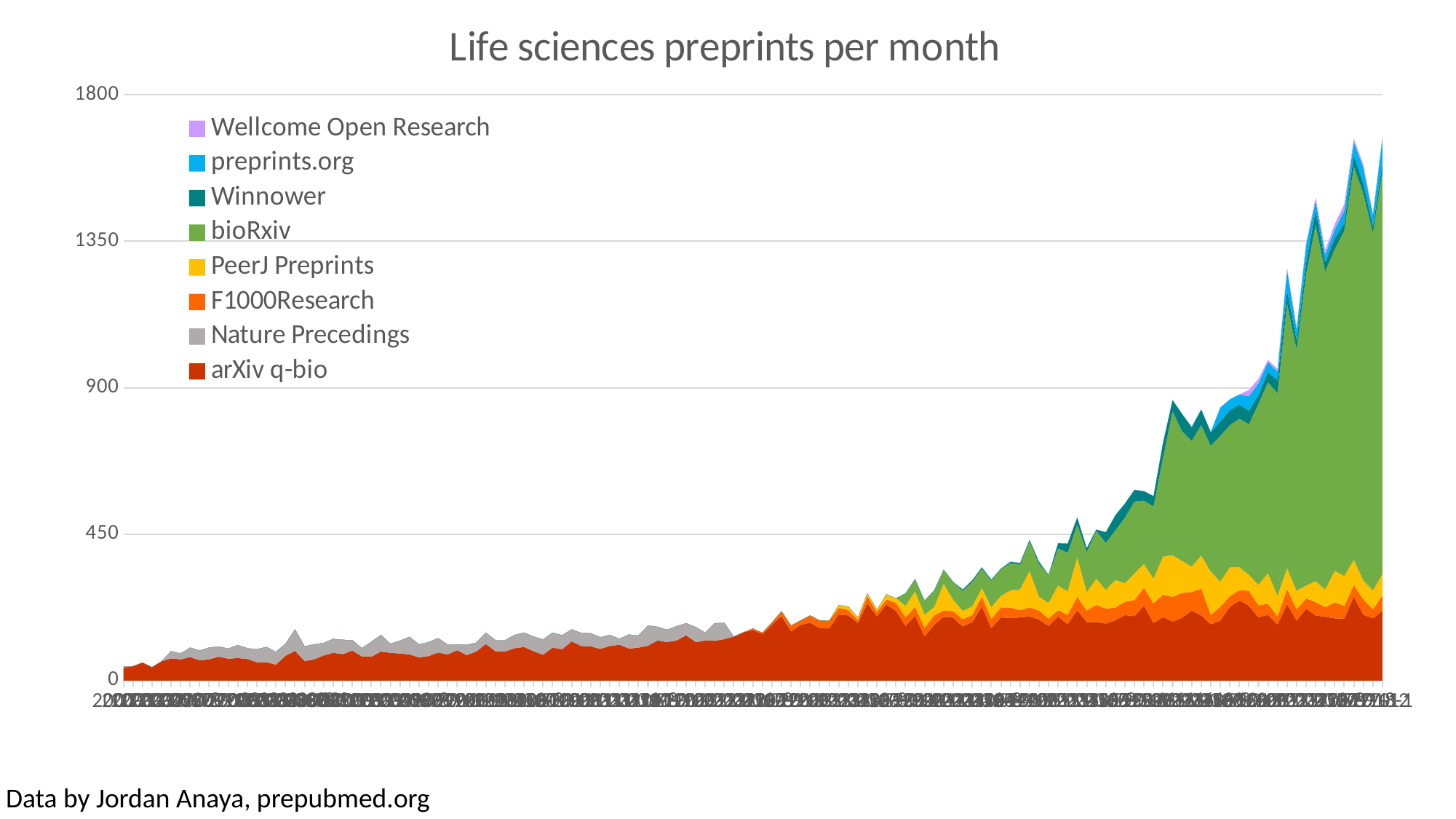
What is the highest value labelled on the y axis? 1800 Do the total monthly preprints rise or fall over time along the x axis? Rise Is the highest total value reached on the chart greater or less than 1350? greater What is the title of the chart? Life sciences preprints per month At the right-hand end of the chart, which is larger: the bioRxiv area or the arXiv q-bio area? bioRxiv How many series does the legend list? 8 Which series forms the bottom layer of the stacked areas? arXiv q-bio Is the total value at the left-hand start of the chart greater or less than 450? less Which series contributes the largest share of the total at the right-hand end of the chart? bioRxiv What kind of chart is shown on the slide? Stacked area chart